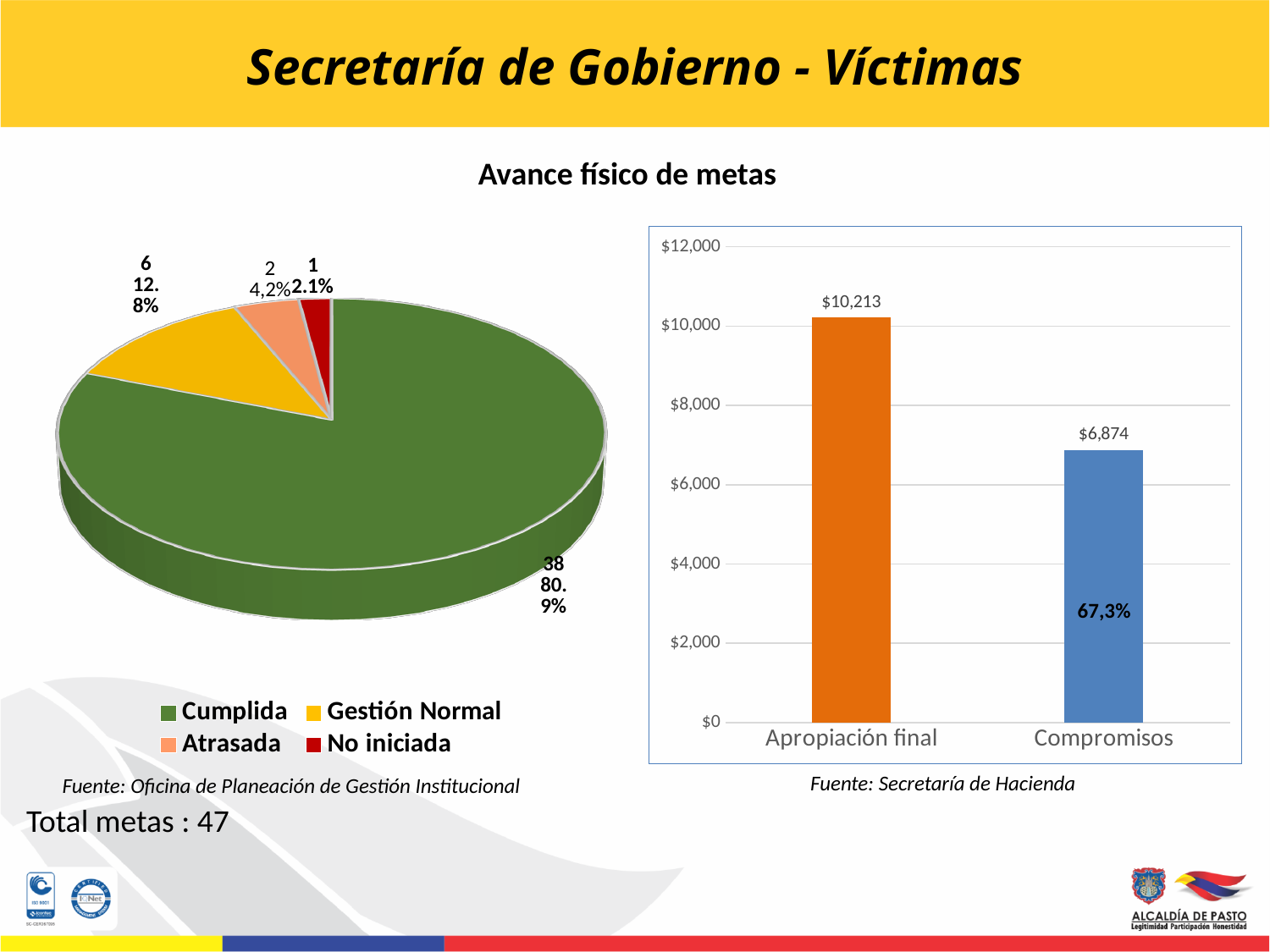
On the pie chart on the left, what percentage share does the Cumplida slice have? 80.9% On the bar chart on the right, what is the difference between Apropiación final and Compromisos? $3,339 On the pie chart on the left, how many metas are in the No iniciada category? 1 How many categories does the legend of the pie chart on the left list? 4 On the pie chart on the left, what colour is the Atrasada slice? Orange (light orange) On the pie chart on the left, how many metas are in the Cumplida category? 38 On the pie chart on the left, which category has the largest slice? Cumplida On the bar chart on the right, what is the value for Apropiación final? $10,213 On the pie chart on the left, which category has the smallest slice? No iniciada On the bar chart on the right, what is the value for Compromisos? $6,874 What kind of chart is shown on the right side of the slide? Bar chart On the pie chart on the left, what percentage share does the Gestión Normal slice have? 12.8%